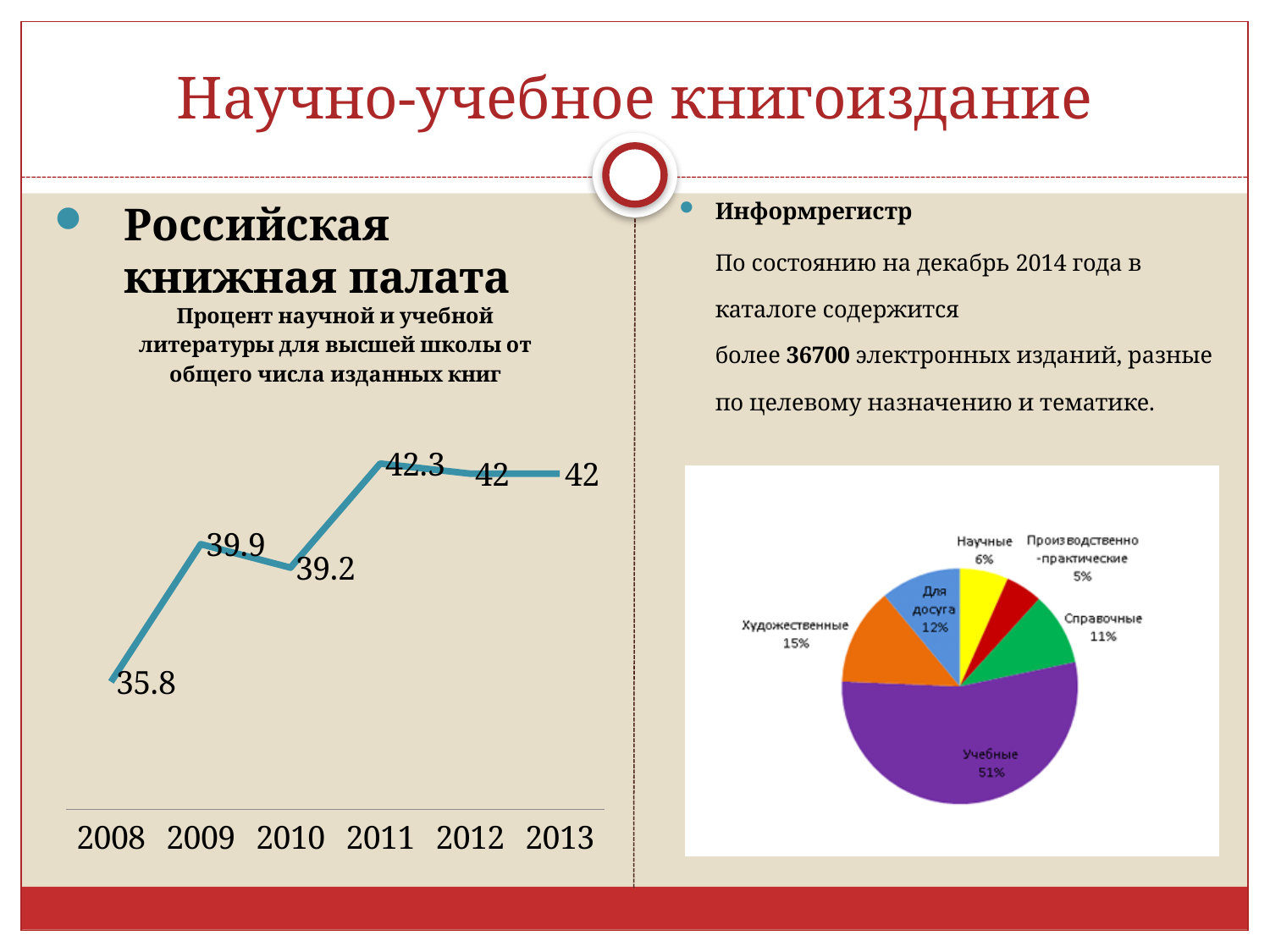
In the pie chart on the right, how many slices are there? 6 In the line chart on the left, what is the value for 2008? 35.8 In the line chart on the left, which year has the lowest value? 2008 In the line chart on the left, which year has the highest value? 2011 In the pie chart on the right, which category has the smallest share? Производственно-практические In the line chart on the left, how many years are plotted? 6 In the line chart on the left, what is the difference between the values for 2011 and 2008? 6.5 What kind of chart is shown on the left side of the slide? line chart In the line chart on the left, which is larger, the value for 2009 or the value for 2010? 2009 In the line chart on the left, what is the value for 2011? 42.3 In the pie chart on the right, what share does Учебные have? 51% In the pie chart on the right, what is the difference between the shares of Художественные and Справочные? 4%